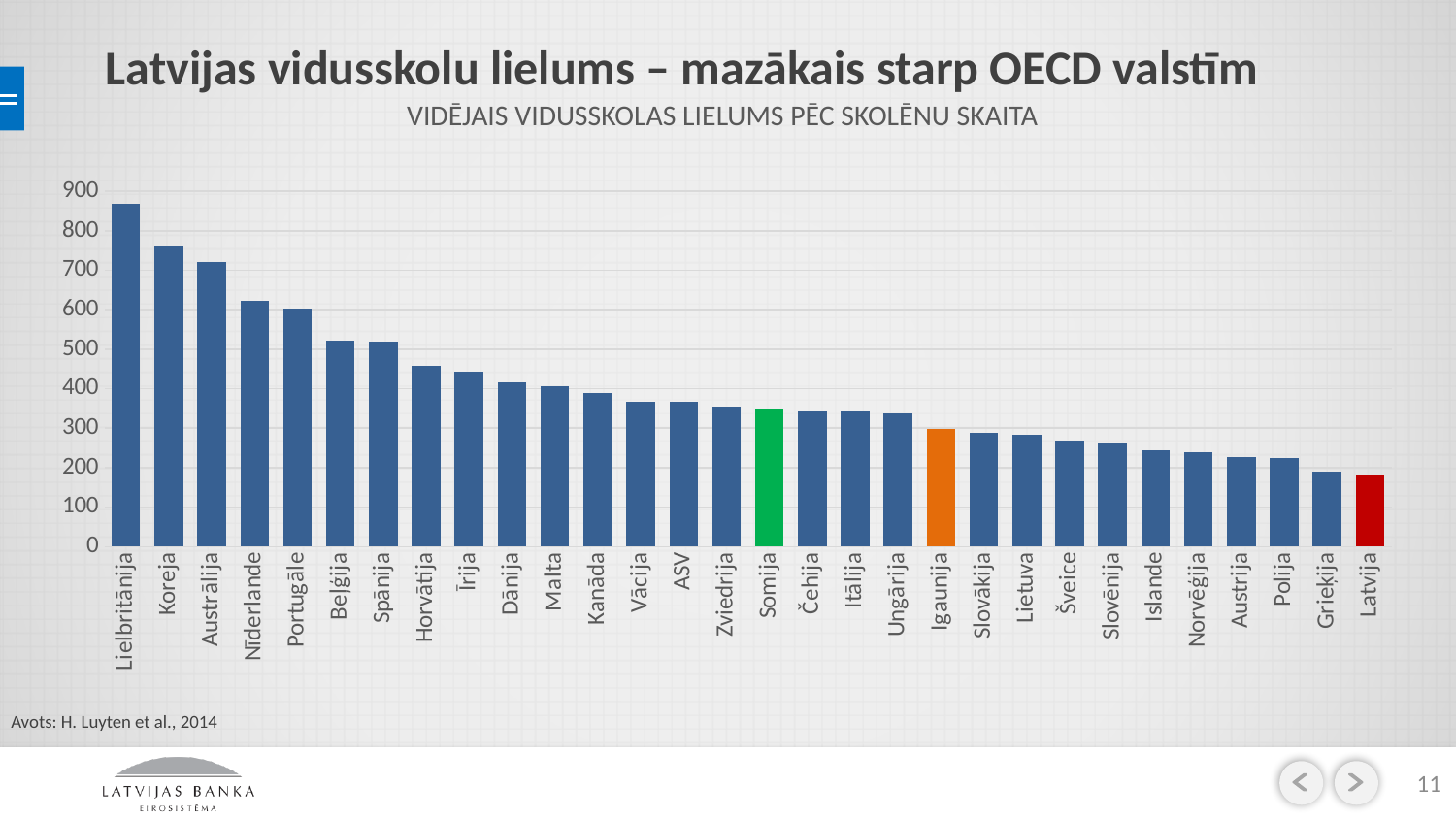
Which country has the lowest average secondary school size in the chart? Latvija Is the value for Somija greater or less than 300? greater Which is larger, the value for Koreja or the value for Austrālija? Koreja Is the value for Nīderlande greater or less than 600? greater Is the value for Lietuva greater or less than 300? less How many countries are shown in the chart? 30 Which country has the highest average secondary school size in the chart? Lielbritānija Do the values rise or fall from left to right along the x axis? fall What kind of chart is shown on the slide? bar chart What colour is the bar for Latvija? red